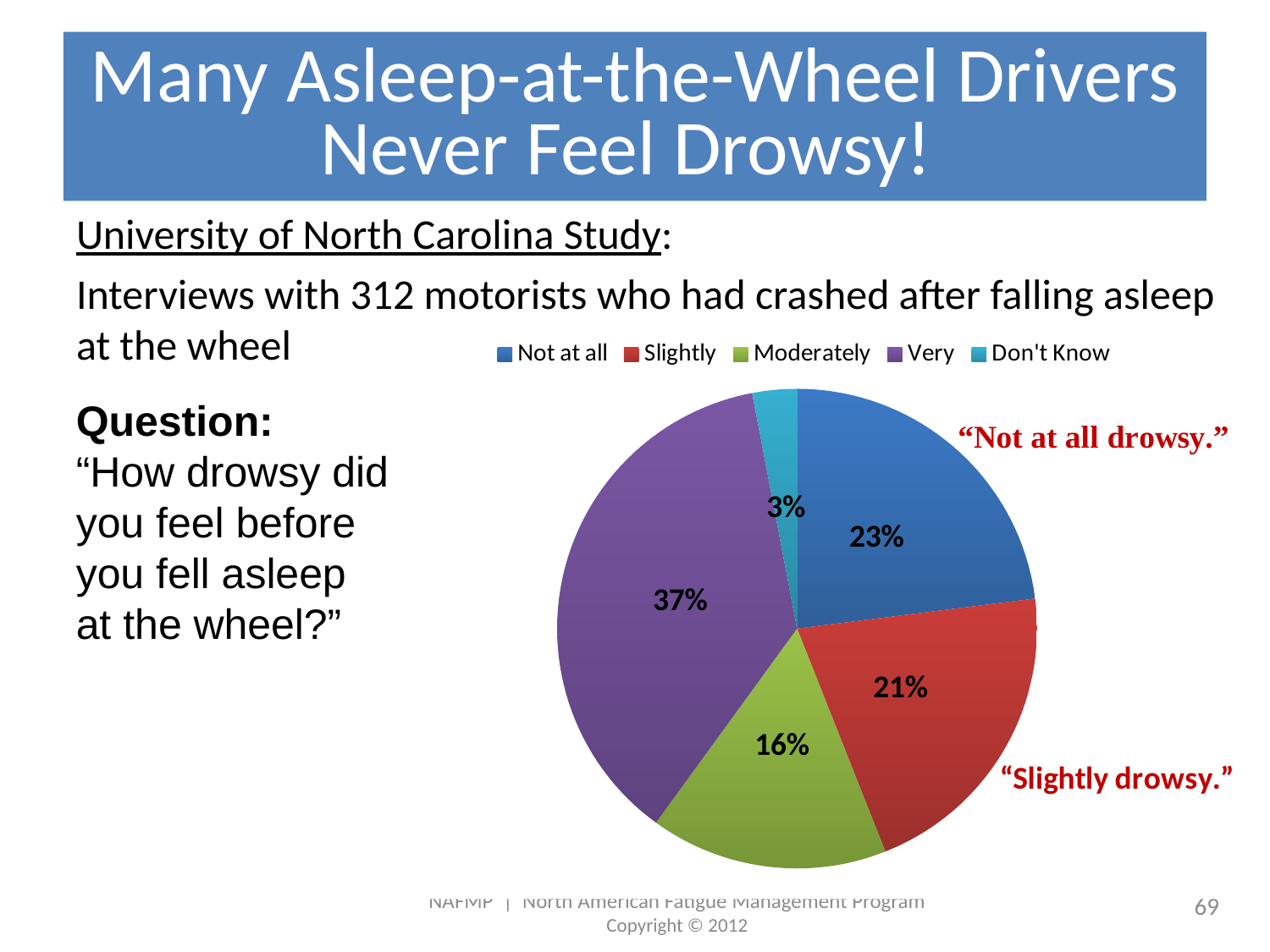
What percentage of drivers reported feeling 'Slightly' drowsy? 21% Which slice is larger: 'Slightly' or 'Moderately'? Slightly What type of chart is shown on the slide? Pie chart What percentage of drivers reported feeling 'Not at all' drowsy? 23% What percentage of drivers reported feeling 'Moderately' drowsy? 16% How many categories does the legend list? 5 Which response category has the smallest share of the pie? Don't Know What is the difference in percentage points between the 'Very' and 'Not at all' slices? 14 What percentage of drivers reported feeling 'Very' drowsy? 37% What colour is the 'Very' slice of the pie? Purple Which response category has the largest share of the pie? Very What percentage of drivers answered 'Don't Know'? 3%